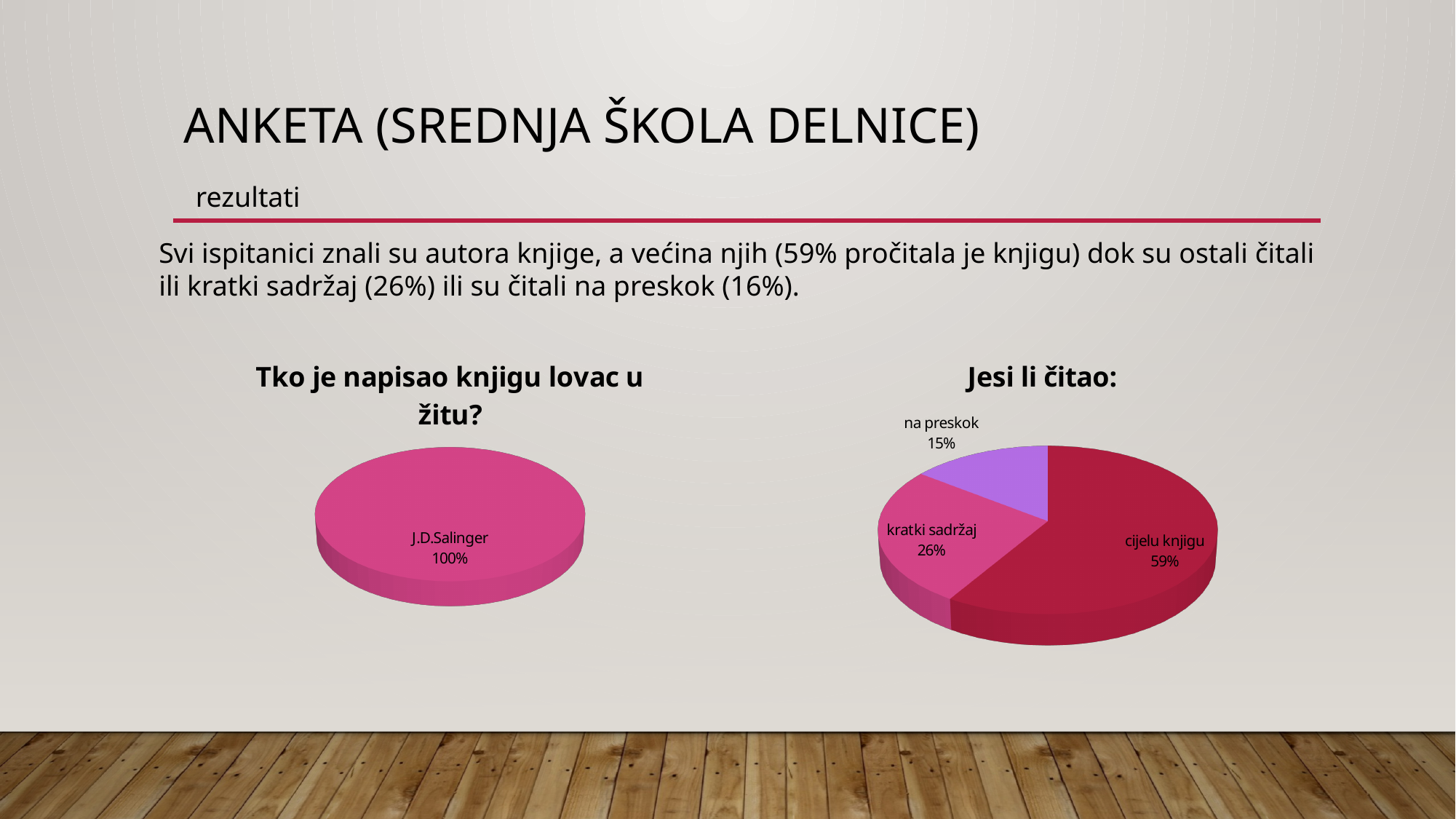
In the chart titled "Jesi li čitao:", which category has the largest slice? cijelu knjigu How many categories are shown in the chart titled "Tko je napisao knjigu lovac u žitu?"? 1 In the chart titled "Jesi li čitao:", which is larger, "kratki sadržaj" or "na preskok"? kratki sadržaj How many categories are shown in the chart titled "Jesi li čitao:"? 3 In the chart titled "Jesi li čitao:", what is the difference in percentage points between "cijelu knjigu" and "kratki sadržaj"? 33 What is the title of the chart on the left side of the slide? Tko je napisao knjigu lovac u žitu? What kind of chart is the chart titled "Jesi li čitao:"? pie chart In the chart titled "Jesi li čitao:", what share of the pie is "kratki sadržaj"? 26% In the chart titled "Jesi li čitao:", what share of the pie is "na preskok"? 15% In the chart titled "Jesi li čitao:", which category has the smallest slice? na preskok In the chart titled "Tko je napisao knjigu lovac u žitu?", what share of the pie is "J.D.Salinger"? 100%